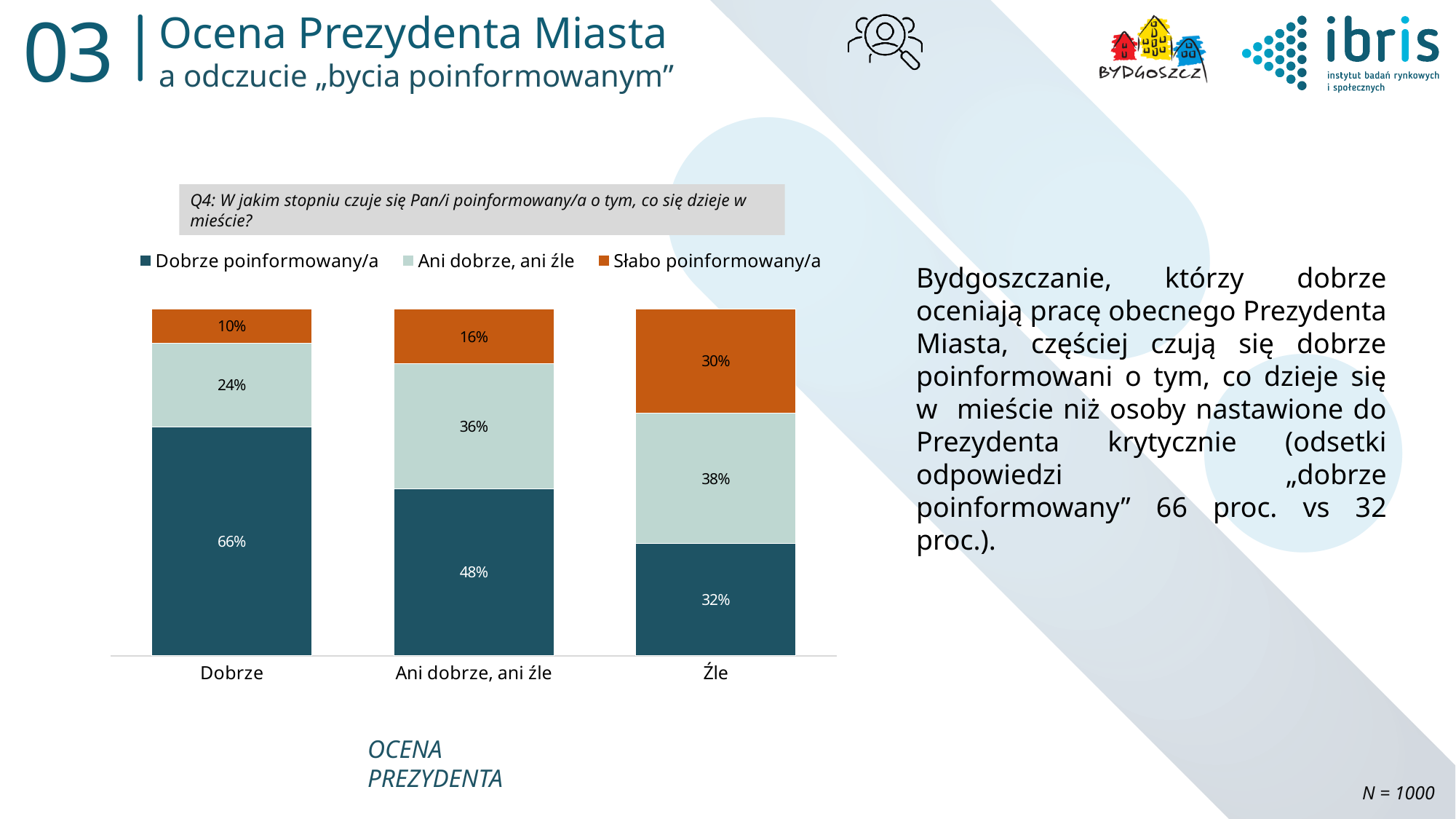
What is the 'Słabo poinformowany/a' value for the 'Źle' category? 30% How many series does the legend list? 3 What percentage of respondents who rate the Mayor 'Dobrze' feel 'Dobrze poinformowany/a'? 66% Does the 'Dobrze poinformowany/a' share rise or fall moving from 'Dobrze' to 'Źle' along the x axis? Fall What is the total of the stacked bar for 'Ani dobrze, ani źle'? 100% What kind of chart is shown? Stacked bar chart How many categories are shown on the x axis? 3 Which category has the highest 'Dobrze poinformowany/a' share? Dobrze What is the difference between the 'Dobrze poinformowany/a' values for 'Dobrze' and 'Źle'? 34 percentage points What is the 'Ani dobrze, ani źle' (informed) value for the 'Ani dobrze, ani źle' rating category? 36% Which category has the lowest 'Słabo poinformowany/a' share? Dobrze Which is larger: the 'Słabo poinformowany/a' value for 'Źle' or for 'Ani dobrze, ani źle'? Źle